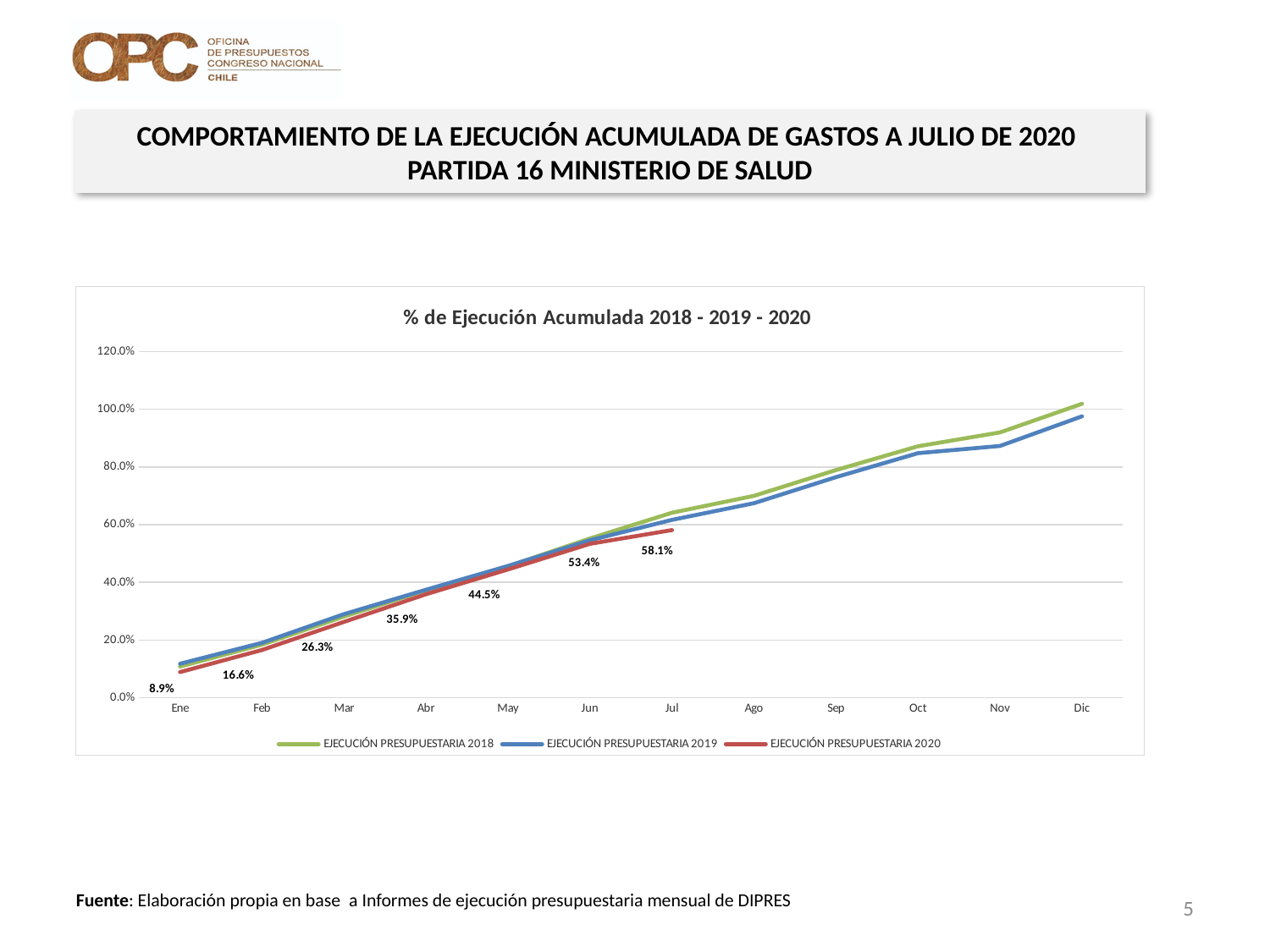
By how much did EJECUCIÓN PRESUPUESTARIA 2020 increase from Jun to Jul? 4.7% What is the value of EJECUCIÓN PRESUPUESTARIA 2020 in Abr? 35.9% What is the title of the chart? % de Ejecución Acumulada 2018 - 2019 - 2020 What kind of chart is shown on the slide? Line chart How many series does the legend list? 3 Is the value for EJECUCIÓN PRESUPUESTARIA 2019 in Dic greater or less than 100.0%? less What is the value of EJECUCIÓN PRESUPUESTARIA 2020 in Ene? 8.9% How many months are shown on the x axis? 12 What is the value of EJECUCIÓN PRESUPUESTARIA 2020 in Jul? 58.1% In Dic, which series is higher: EJECUCIÓN PRESUPUESTARIA 2018 or EJECUCIÓN PRESUPUESTARIA 2019? EJECUCIÓN PRESUPUESTARIA 2018 Do the values of EJECUCIÓN PRESUPUESTARIA 2020 rise or fall from Ene to Jul? Rise What is the difference between the EJECUCIÓN PRESUPUESTARIA 2020 values for Mar and Feb? 9.7%